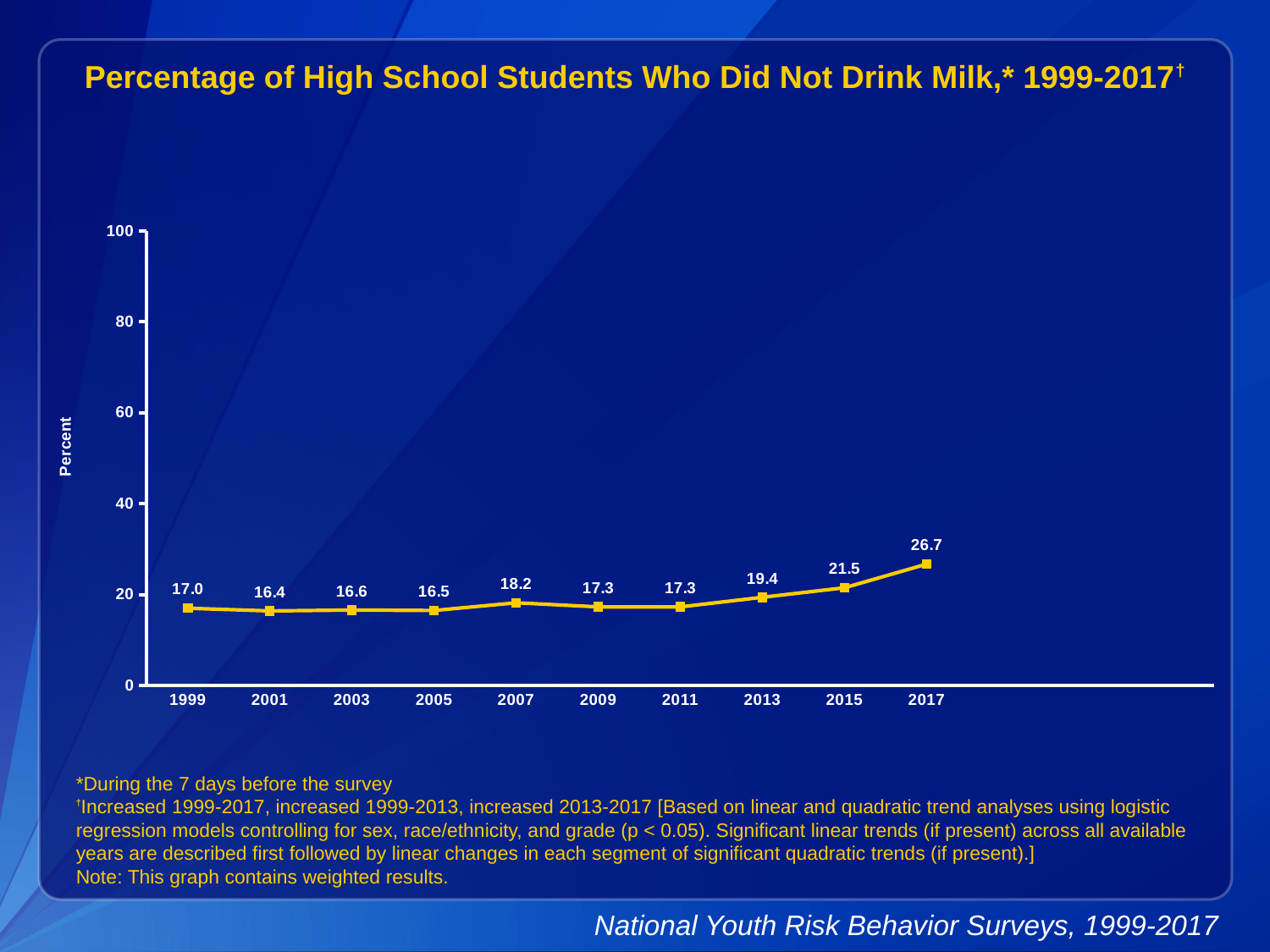
What is the value plotted for 1999? 17.0 Which year has a larger value, 2005 or 2013? 2013 What kind of chart is shown on the slide? Line chart How many years are plotted on the chart? 10 What is the difference between the values for 2017 and 2015? 5.2 What is the difference between the values for 2013 and 1999? 2.4 What is the label on the y axis? Percent Which year has the highest percentage of students who did not drink milk? 2017 What is the value plotted for 2007? 18.2 Which year has the lowest percentage of students who did not drink milk? 2001 Is the value for 2017 greater or less than 20? greater What percentage of high school students did not drink milk in 2017? 26.7